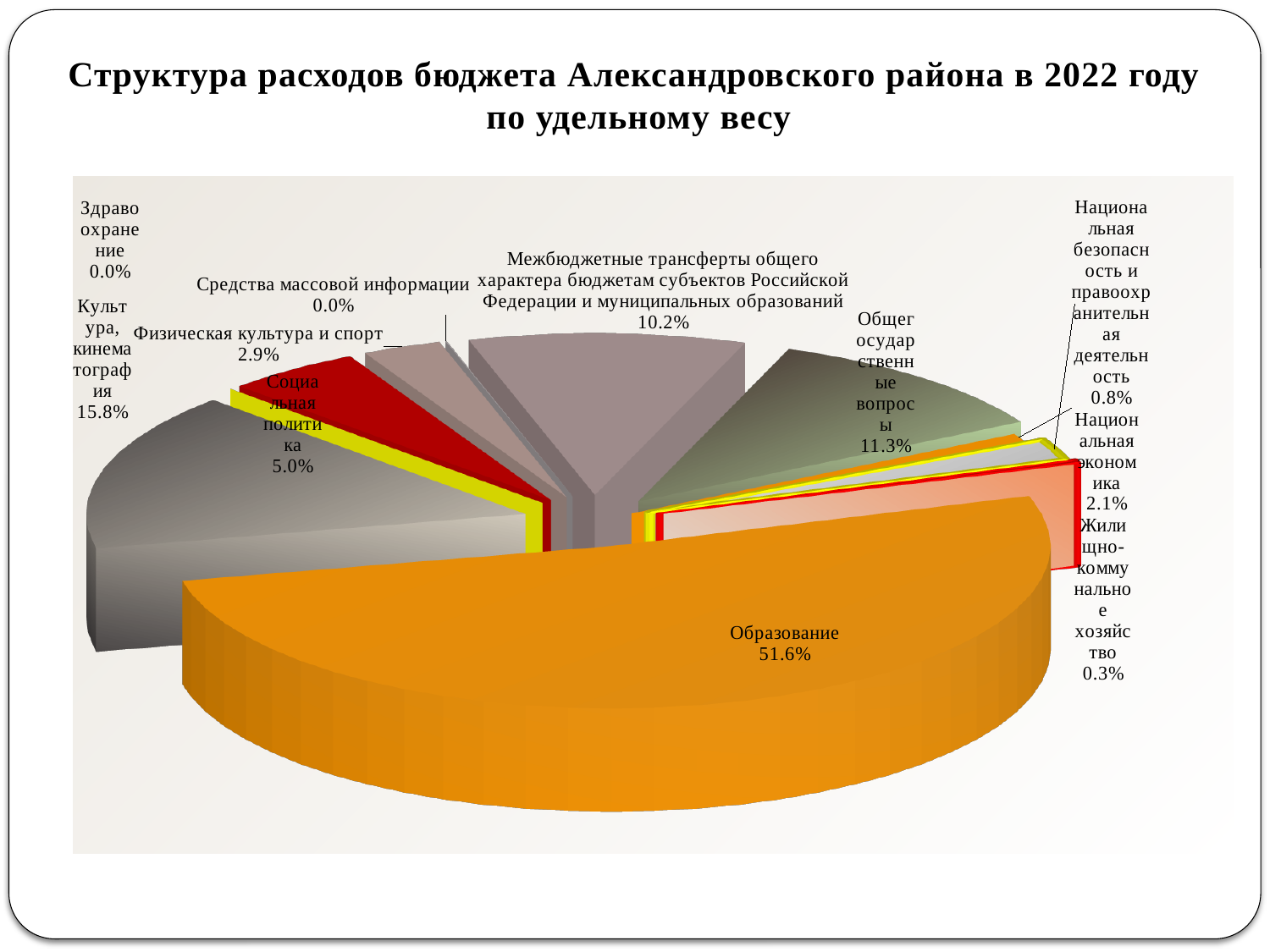
What is the share for Социальная политика? 5.0% What is the share for Национальная безопасность и правоохранительная деятельность? 0.8% What is the share for Общегосударственные вопросы? 11.3% What kind of chart is shown on the slide? pie chart What is the title of the chart? Структура расходов бюджета Александровского района в 2022 году по удельному весу Which is larger: the share for Общегосударственные вопросы or the share for Межбюджетные трансферты общего характера? Общегосударственные вопросы What share of the budget expenditure goes to Образование? 51.6% Which two categories have a share of 0.0%? Здравоохранение and Средства массовой информации Which category has the largest share of the budget expenditure? Образование How many expenditure categories are labelled on the pie chart? 11 What is the difference between the shares of Образование and Культура, кинематография? 35.8% What is the share for Культура, кинематография? 15.8%